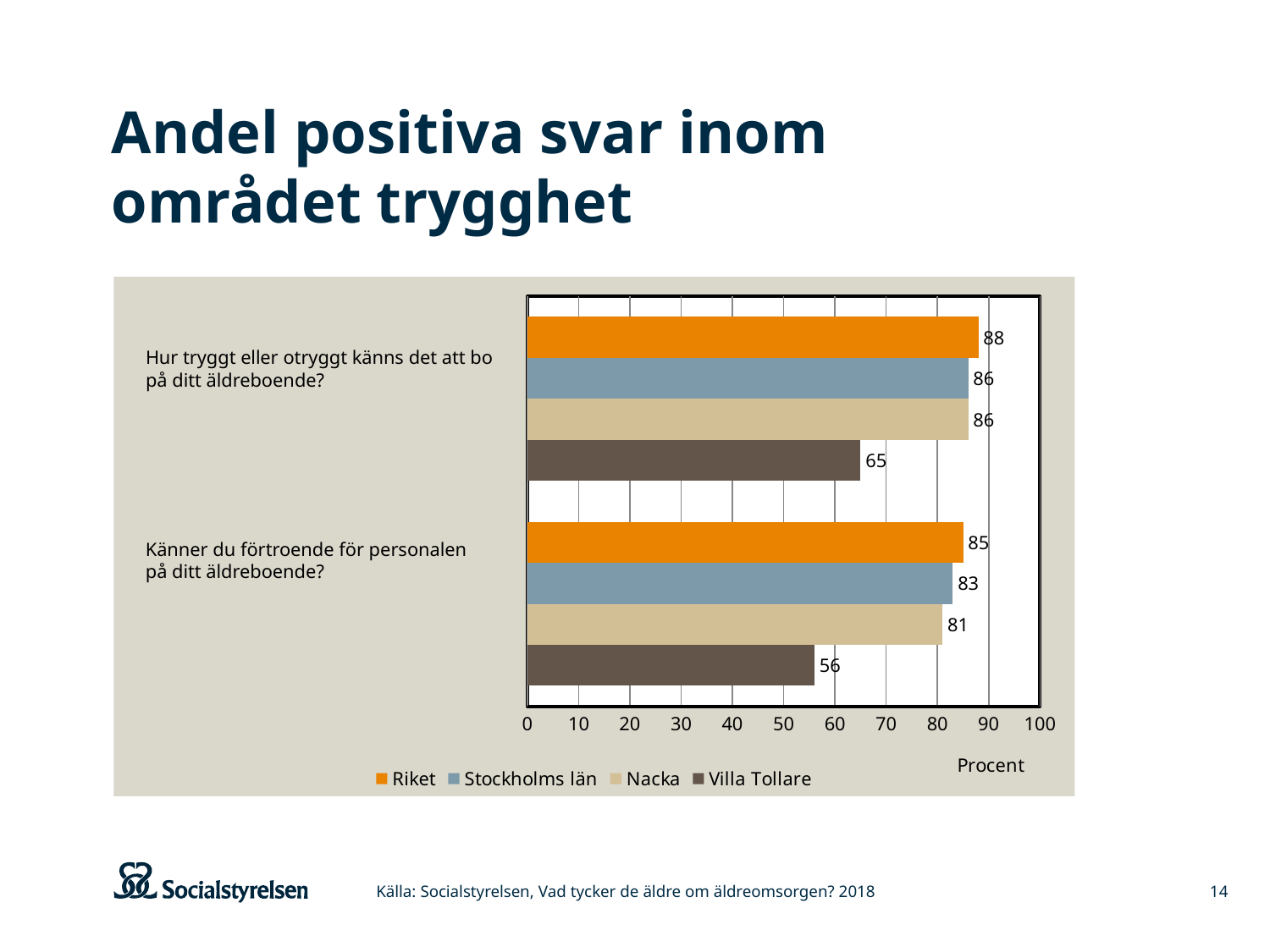
Which series has the lowest value on the question "Hur tryggt eller otryggt känns det att bo på ditt äldreboende?"? Villa Tollare How many series does the legend list? 4 What is the value for Villa Tollare on the question "Känner du förtroende för personalen på ditt äldreboende?"? 56 What is the value for Nacka on the question "Känner du förtroende för personalen på ditt äldreboende?"? 81 What is the label of the horizontal axis? Procent What kind of chart is shown on the slide? Bar chart What is the difference between Stockholms län and Nacka on the question "Känner du förtroende för personalen på ditt äldreboende?"? 2 What is the difference between Riket and Villa Tollare on the question "Hur tryggt eller otryggt känns det att bo på ditt äldreboende?"? 23 What is the value for Stockholms län on the question "Hur tryggt eller otryggt känns det att bo på ditt äldreboende?"? 86 What is the value for Riket on the question "Hur tryggt eller otryggt känns det att bo på ditt äldreboende?"? 88 Which series has the highest value on the question "Känner du förtroende för personalen på ditt äldreboende?"? Riket Which is larger: Villa Tollare on "Hur tryggt eller otryggt känns det att bo på ditt äldreboende?" or Villa Tollare on "Känner du förtroende för personalen på ditt äldreboende?"? Hur tryggt eller otryggt känns det att bo på ditt äldreboende?